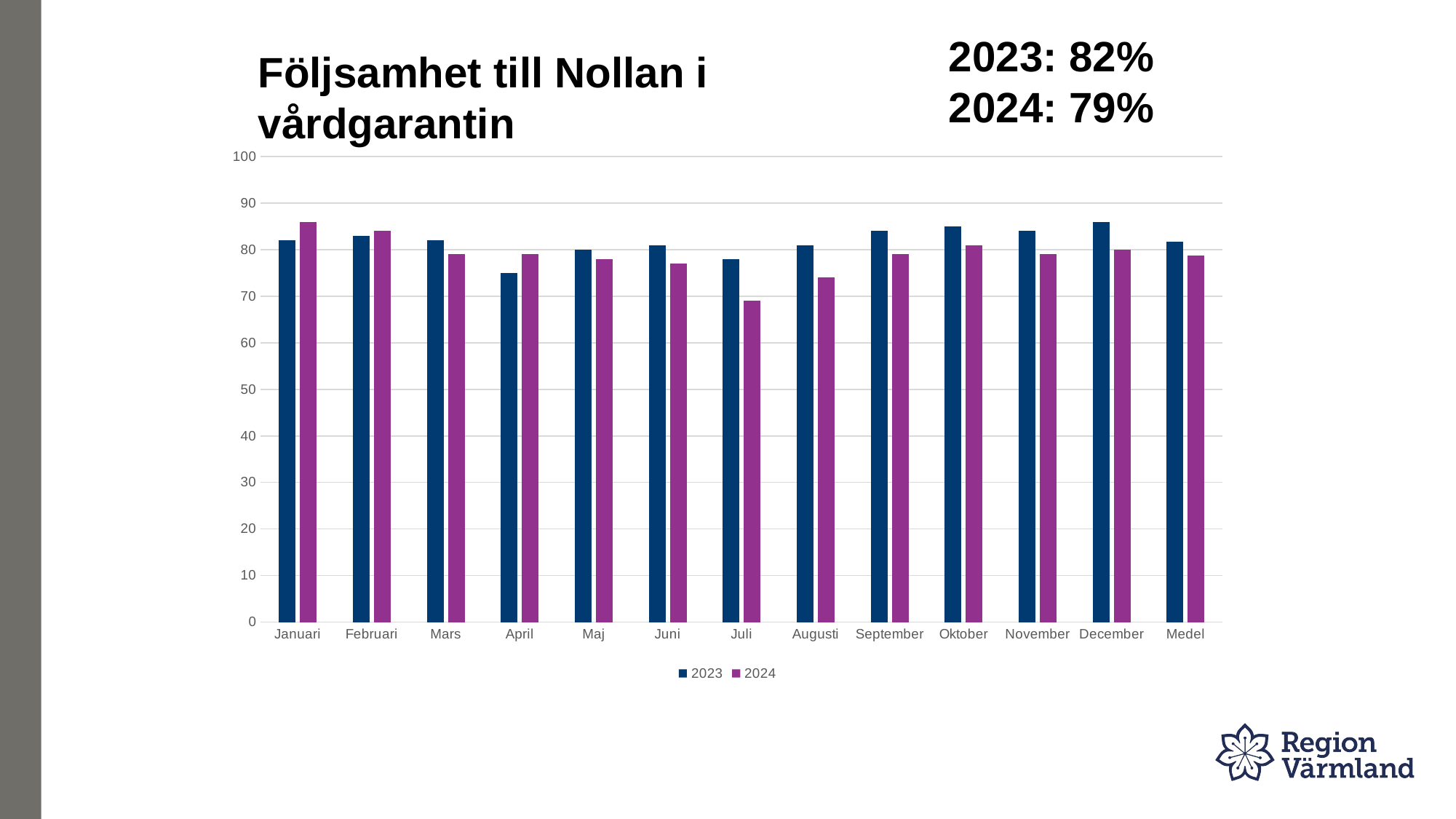
How many categories are shown on the x axis? 13 In which month is the 2023 value the lowest? April Is the 2024 value for Juli greater or less than 80? less In which month is the 2024 value the lowest? Juli Which series is shown in purple? 2024 For Januari, which series has the larger value, 2023 or 2024? 2024 What kind of chart is shown on the slide? Bar chart In which month is the 2024 value the highest? Januari For Juli, which series has the larger value, 2023 or 2024? 2023 Is the 2023 value for April greater or less than 80? less How many series does the legend list? 2 What is the title of the chart? Följsamhet till Nollan i vårdgarantin